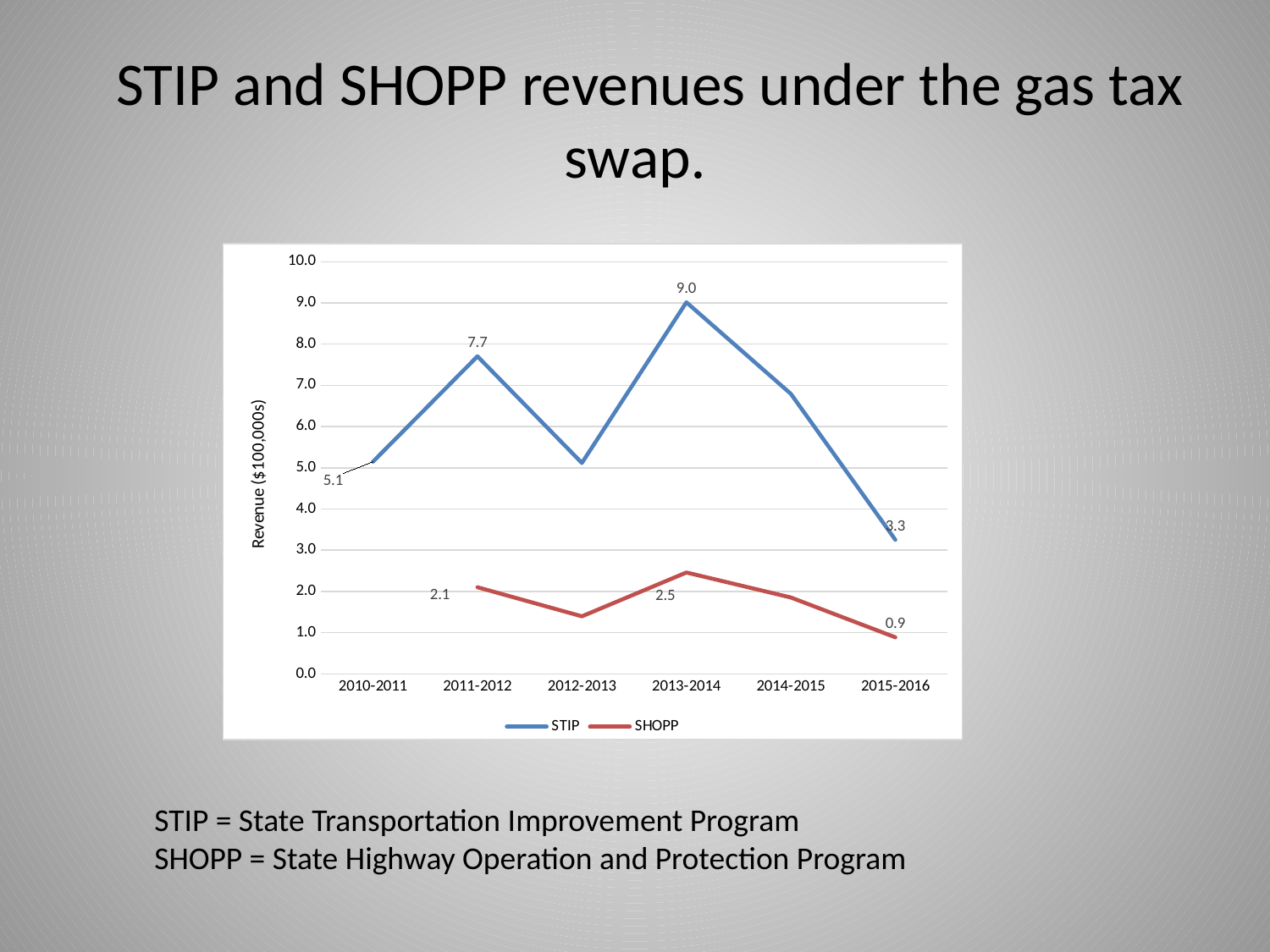
Is the STIP value for 2014-2015 greater or less than 6.0? greater What is the SHOPP revenue value for 2015-2016? 0.9 What is the difference between the STIP values for 2013-2014 and 2015-2016? 5.7 What is the STIP value for 2010-2011? 5.1 In 2011-2012, how much larger is the STIP value than the SHOPP value? 5.6 In which year is the STIP revenue highest? 2013-2014 How many series does the legend list? 2 In which year is the STIP revenue lowest? 2015-2016 Which series has the larger value in 2013-2014, STIP or SHOPP? STIP What is the STIP revenue value for 2013-2014? 9.0 How many fiscal years are shown on the x axis? 6 Is the SHOPP value for 2012-2013 greater or less than 2.0? less